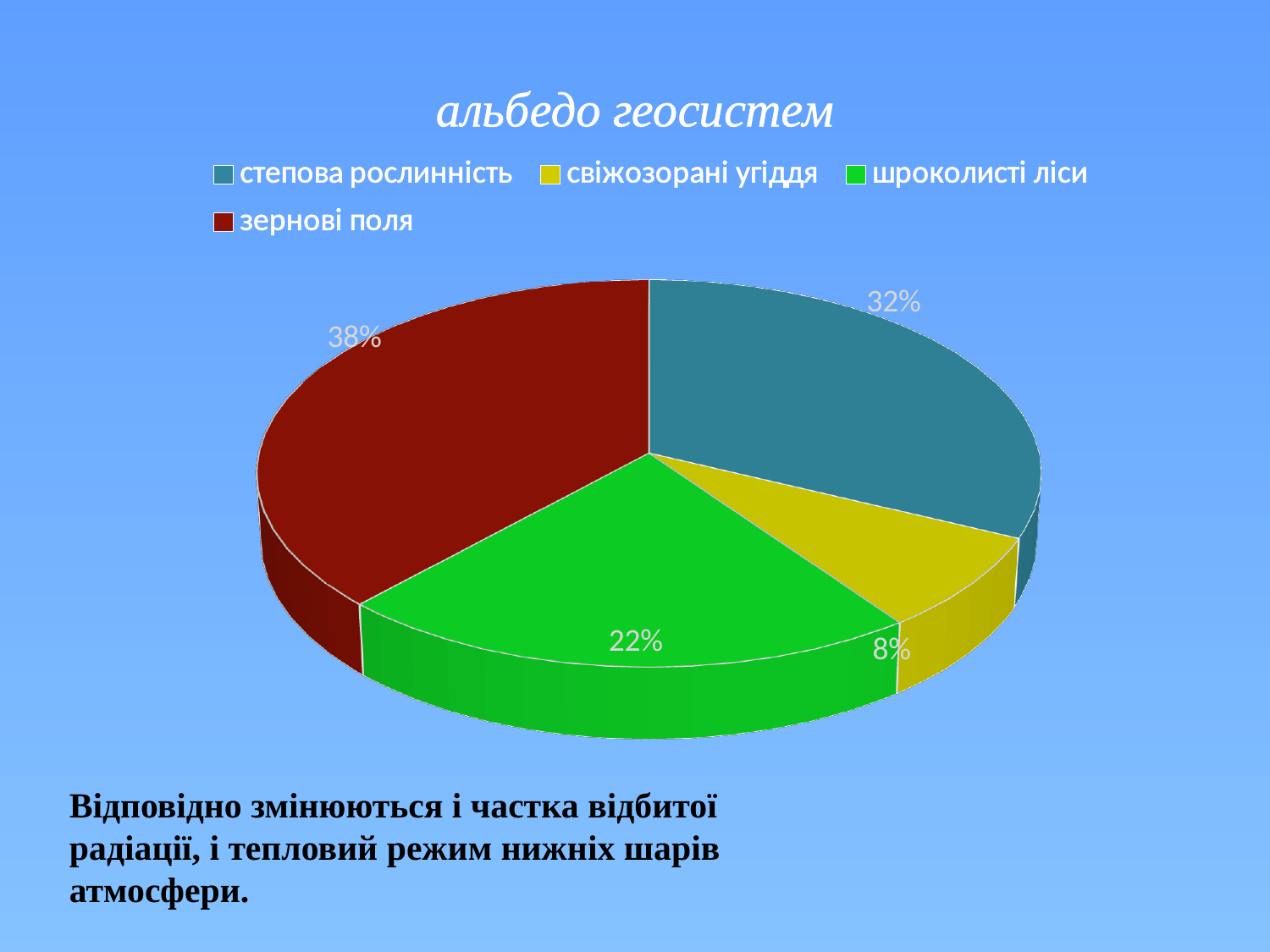
What is the title of the chart? альбедо геосистем Which is larger, the share of шроколисті ліси or the share of свіжозорані угіддя? шроколисті ліси What share of the pie does степова рослинність have? 32% Which category has the largest slice of the pie? зернові поля Which category has the smallest slice of the pie? свіжозорані угіддя What share of the pie does зернові поля have? 38% What share of the pie does шроколисті ліси have? 22% What kind of chart is shown on the slide? pie chart Which colour represents зернові поля in the pie chart? dark red What is the difference between the shares of зернові поля and степова рослинність? 6% How many slices does the pie chart have? 4